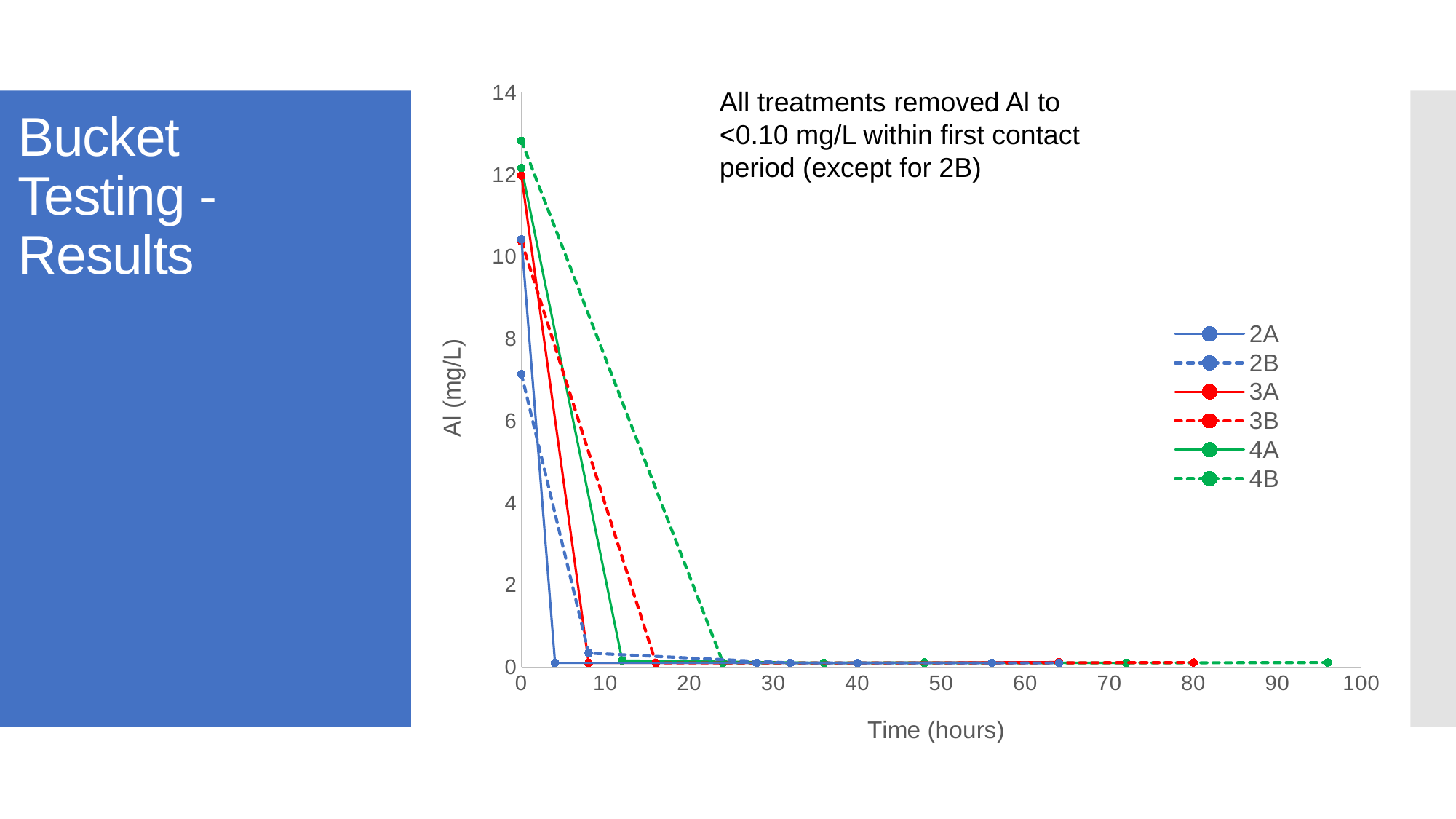
Is the Al value for 2A at time 0 greater or less than 12? less What is the label of the x axis? Time (hours) How many series does the legend list? 6 Is the Al value for 4B at time 0 greater or less than 12? greater Which series has the lowest Al value at time 0? 2B Do the Al values rise or fall as time increases? fall Which series extends to the latest time on the x axis? 4B At time 0, which series has the larger Al value, 2A or 2B? 2A What kind of chart is shown on the slide? line chart Is the Al value for 2B at time 0 greater or less than 8? less Which series has the highest Al value at time 0? 4B What is the label of the y axis? Al (mg/L)